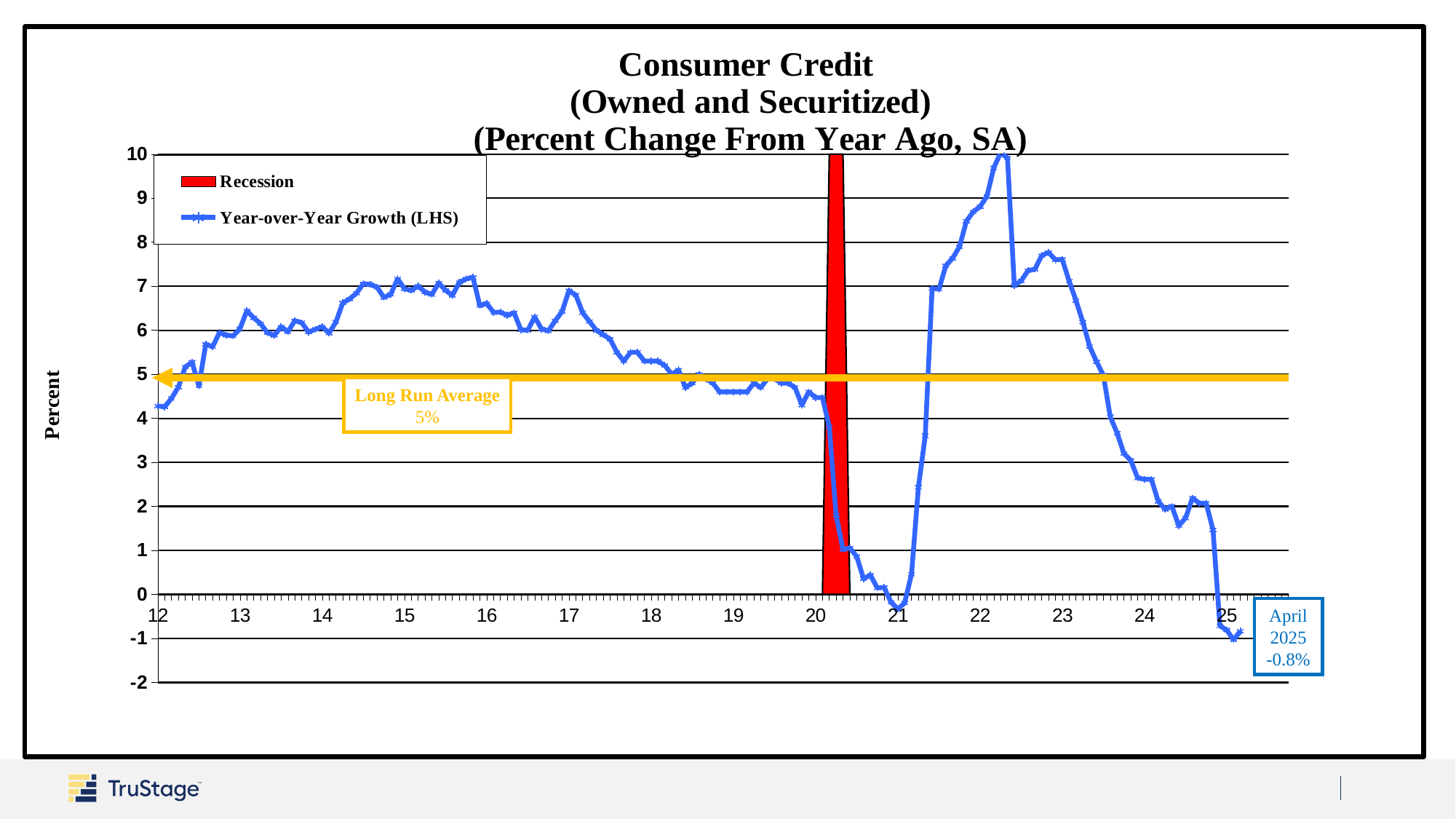
Is the peak value of Year-over-Year Growth around 2022 greater or less than 9? greater Is the Year-over-Year Growth value at 2015 greater or less than 6? greater What kind of chart is shown on the slide? line chart How many entries does the legend list? 2 Does the Year-over-Year Growth line rise or fall between 2012 and 2015? rise Does the Year-over-Year Growth line rise or fall between 2022 and 2025? fall What colour is used to mark the recession period on the chart? red Is the Year-over-Year Growth value at the start of 2021 greater or less than 1? less What is the long run average value marked on the chart? 5% What is the title of the chart? Consumer Credit (Owned and Securitized) (Percent Change From Year Ago, SA) Which is higher: the peak of Year-over-Year Growth around 2022 or the peak around 2015? 2022 What is the year-over-year growth value for April 2025 shown in the callout? -0.8%